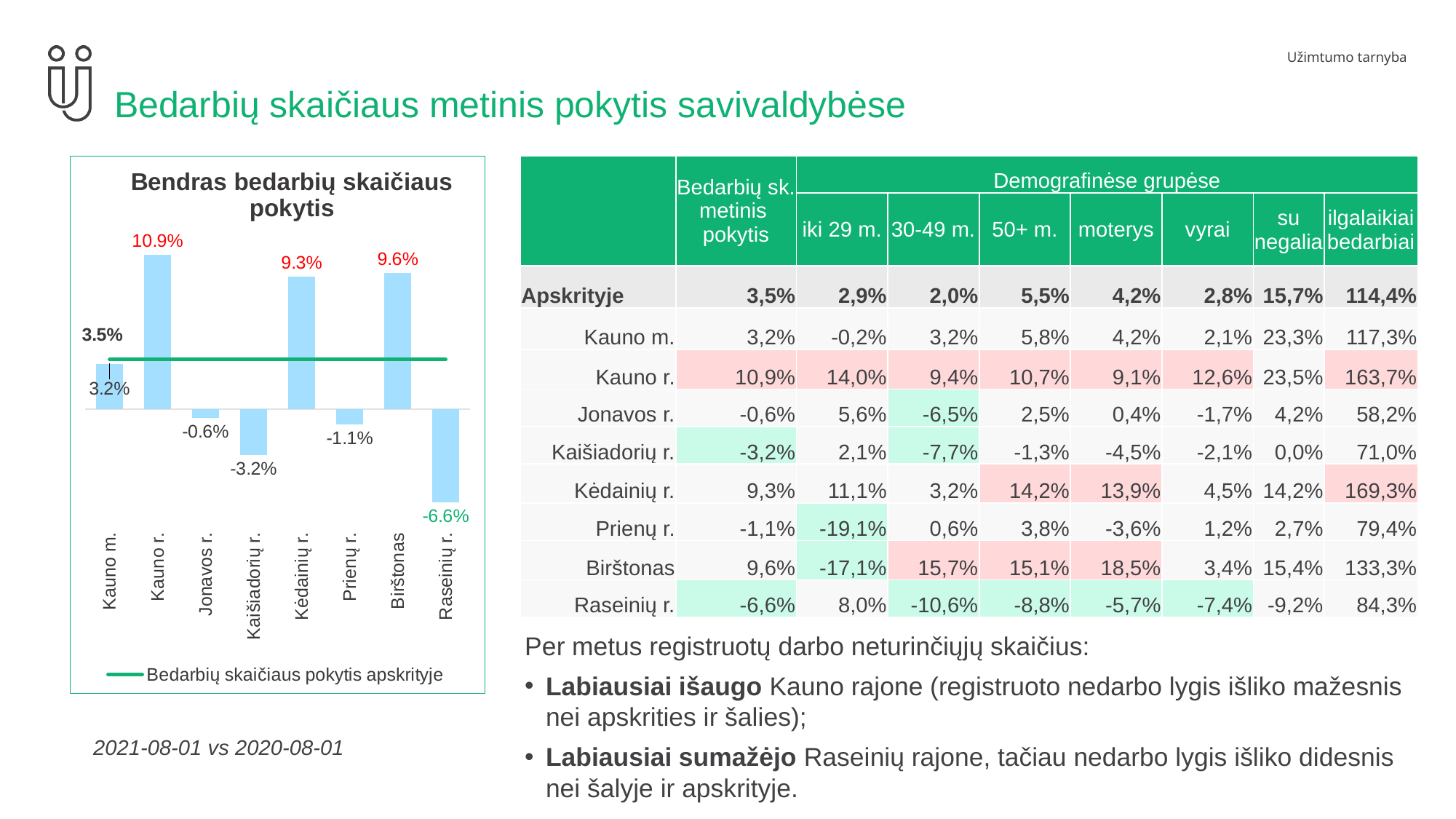
What is the value shown for Kaišiadorių r. in the chart? -3.2% What type of chart is shown on the slide? Combination bar and line chart What is the title of the chart on the slide? Bendras bedarbių skaičiaus pokytis What is the value shown for Raseinių r. in the chart? -6.6% How many entries does the chart's legend list? 1 How many municipalities are shown on the x axis of the chart? 8 What is the value shown for Kauno r. in the chart? 10.9% Which municipality has the lowest value in the chart? Raseinių r. What is the difference between the values for Kauno r. and Kėdainių r. in the chart? 1.6 percentage points What value does the horizontal line for the apskritis (county) show in the chart? 3.5% Which has a larger value in the chart, Birštonas or Kėdainių r.? Birštonas Which municipality has the highest value in the chart? Kauno r.